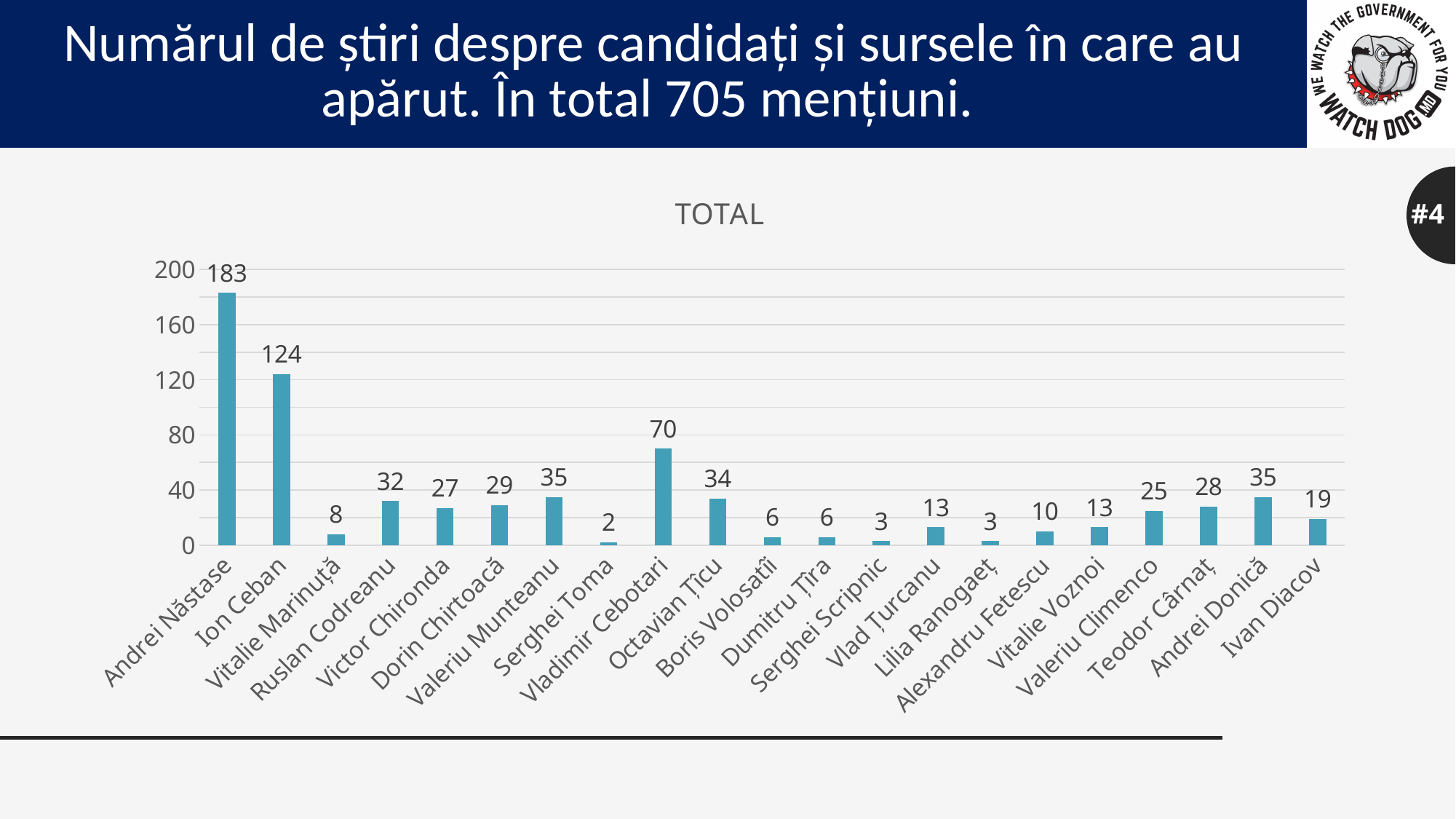
Is the value for Ion Ceban greater or less than 120? greater What is the difference between the values for Vladimir Cebotari and Octavian Țîcu? 36 What is the difference between the values for Andrei Năstase and Ion Ceban? 59 Which candidate has the lowest value? Serghei Toma Which candidate has the highest value? Andrei Năstase What is the title of the chart? TOTAL What kind of chart is shown on the slide? bar chart Which is larger, the value for Ruslan Codreanu or the value for Victor Chironda? Ruslan Codreanu What is the value for Andrei Năstase? 183 What is the value for Teodor Cârnaț? 28 How many candidates are shown on the x axis? 21 What is the value for Vladimir Cebotari? 70